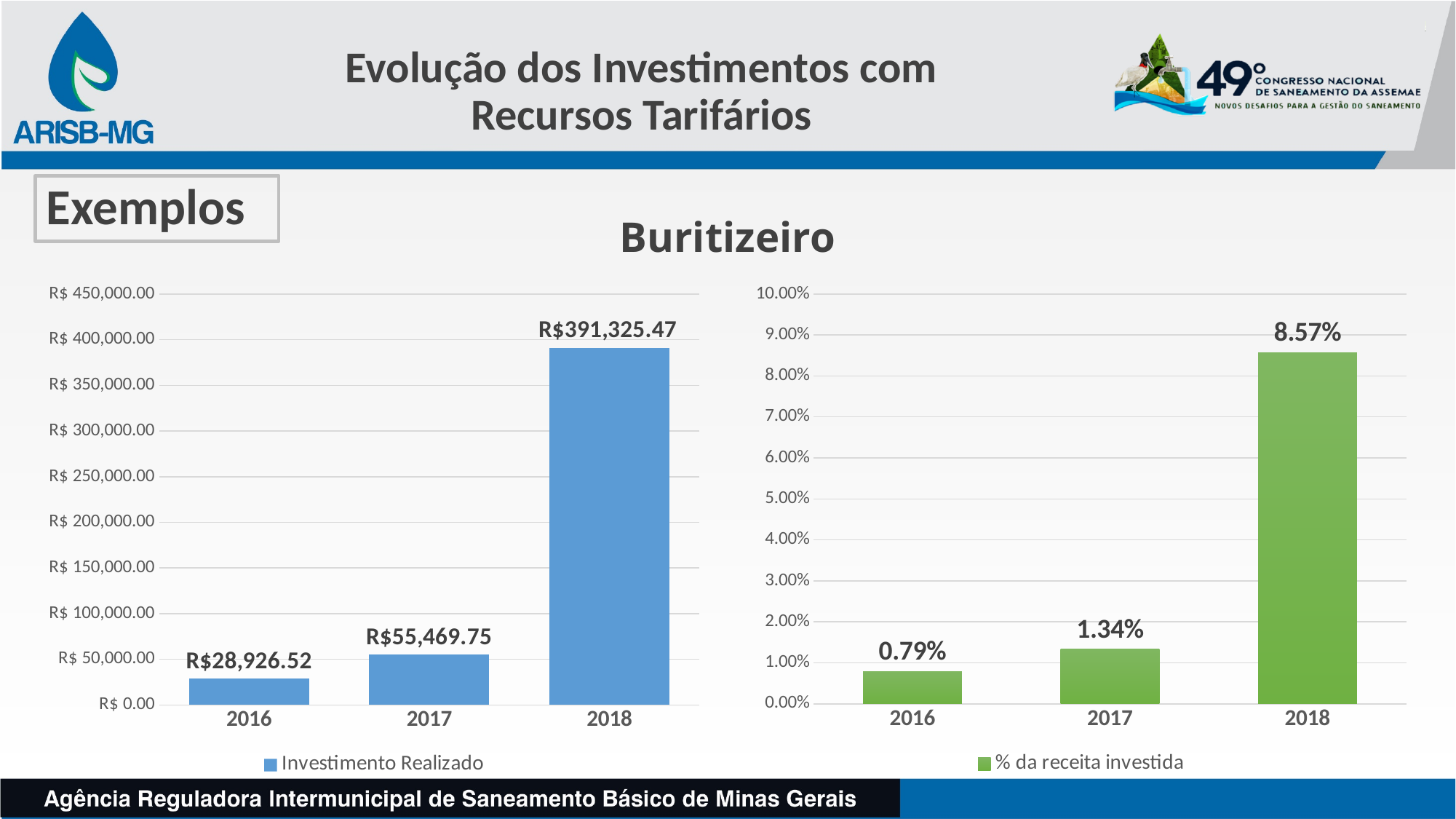
What kind of chart is the right chart (% da receita investida)? bar chart How many years are shown on the x axis of the left chart (Investimento Realizado)? 3 In the left chart (Investimento Realizado), which year has the lowest value? 2016 In the right chart (% da receita investida), do the values rise or fall from 2016 to 2018? rise In the right chart (% da receita investida), which year has the highest value? 2018 In the left chart (Investimento Realizado), what is the value for 2016? R$28,926.52 In the right chart (% da receita investida), which is larger, the value for 2016 or the value for 2017? 2017 In the right chart (% da receita investida), what is the value for 2017? 1.34% In the right chart (% da receita investida), what is the difference between the 2018 and 2017 values? 7.23% In the left chart (Investimento Realizado), what is the value for 2018? R$391,325.47 In the left chart (Investimento Realizado), is the value for 2017 greater or less than R$ 100,000.00? less In the left chart (Investimento Realizado), what is the difference between the 2018 and 2017 values? R$335,855.72